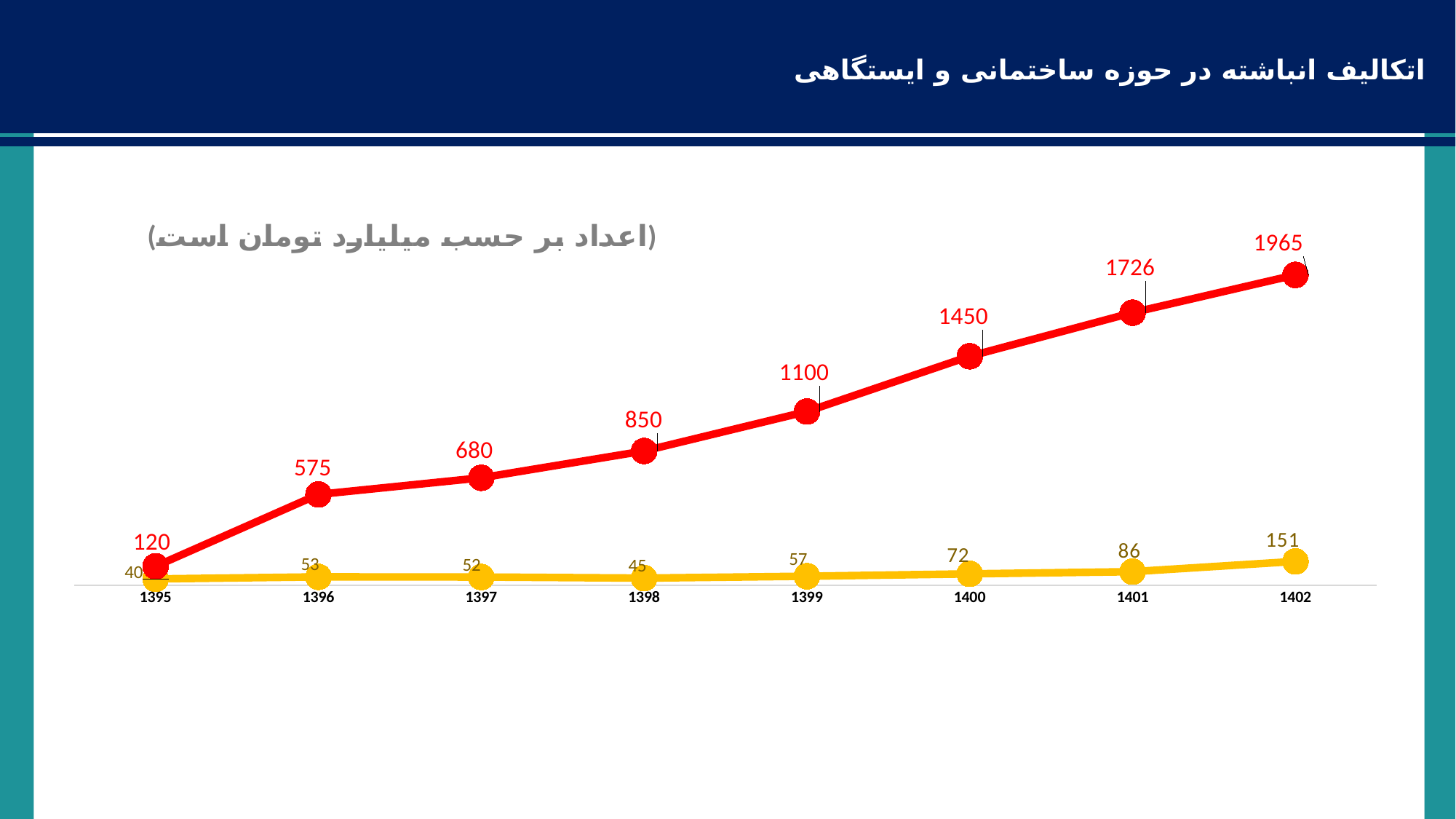
What is the value of the yellow line for 1401? 86 How many years are plotted along the x axis? 8 In which year does the red line reach its highest value? 1402 What is the difference between the red line's values for 1402 and 1401? 239 What kind of chart is shown on the slide? line chart What is the value of the yellow line for 1399? 57 What is the value of the red line for 1398? 850 In which year does the red line have its lowest value? 1395 Does the red line rise or fall from 1395 to 1402? rise What is the difference between the yellow line's values for 1402 and 1401? 65 Which is larger: the red line's value for 1396 or its value for 1397? 1397 What is the value of the red line for 1402? 1965